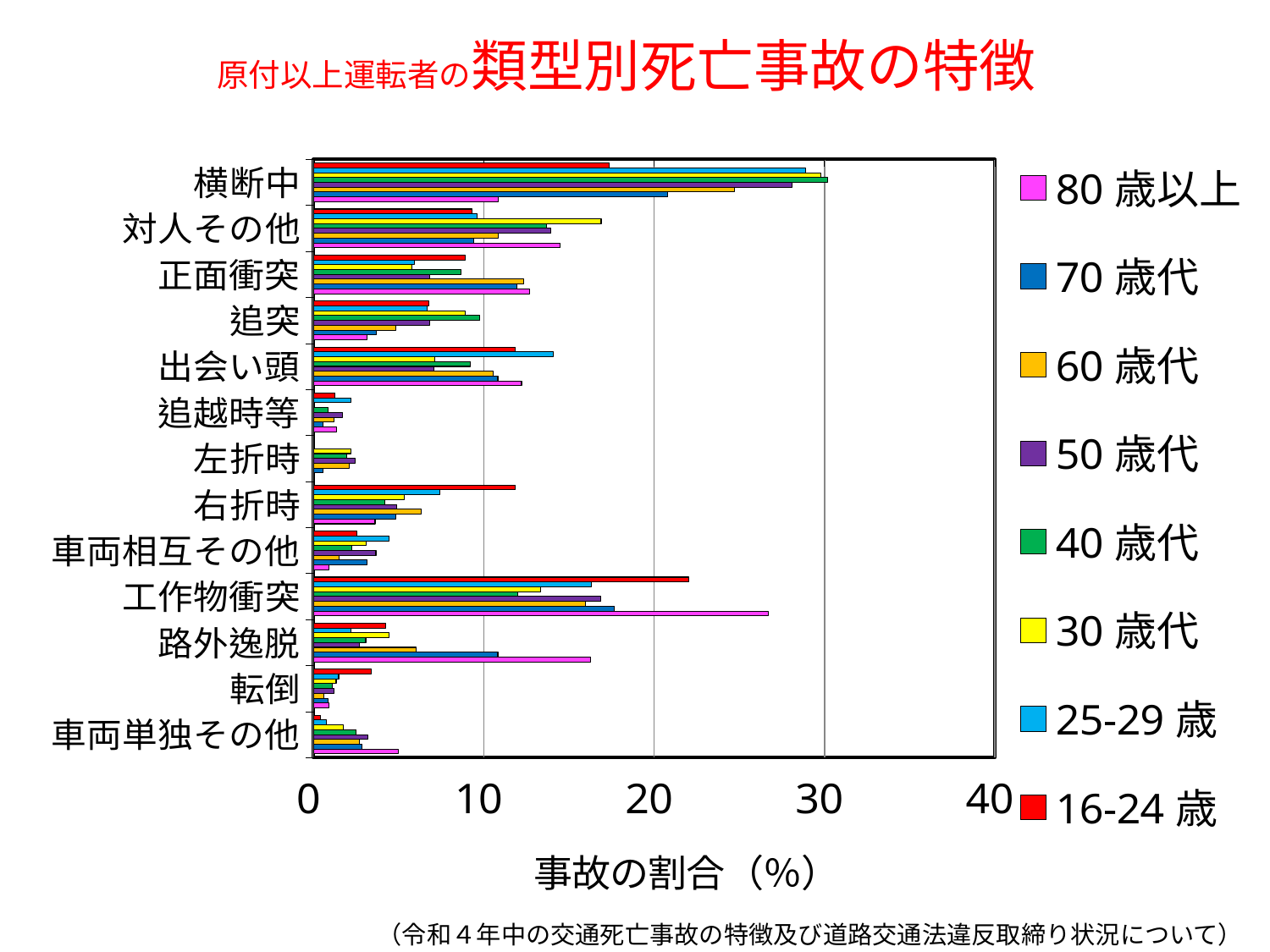
Is the value for 横断中 in the 16-24 歳 series greater or less than 20? less In the 80 歳以上 series, which category has the highest value? 工作物衝突 In the 70 歳代 series, which category has the highest value? 横断中 How many age-group series does the legend list? 8 Is the value for 工作物衝突 in the 80 歳以上 series greater or less than 20? greater How many accident-type categories are listed on the vertical axis? 13 For 横断中, which is larger: the 16-24 歳 value or the 80 歳以上 value? 16-24 歳 Is the value for 出会い頭 in the 25-29 歳 series greater or less than 10? greater For 工作物衝突, which is larger: the 80 歳以上 value or the 16-24 歳 value? 80 歳以上 What is the title of the horizontal axis? 事故の割合（%） What kind of chart is shown on the slide? bar chart